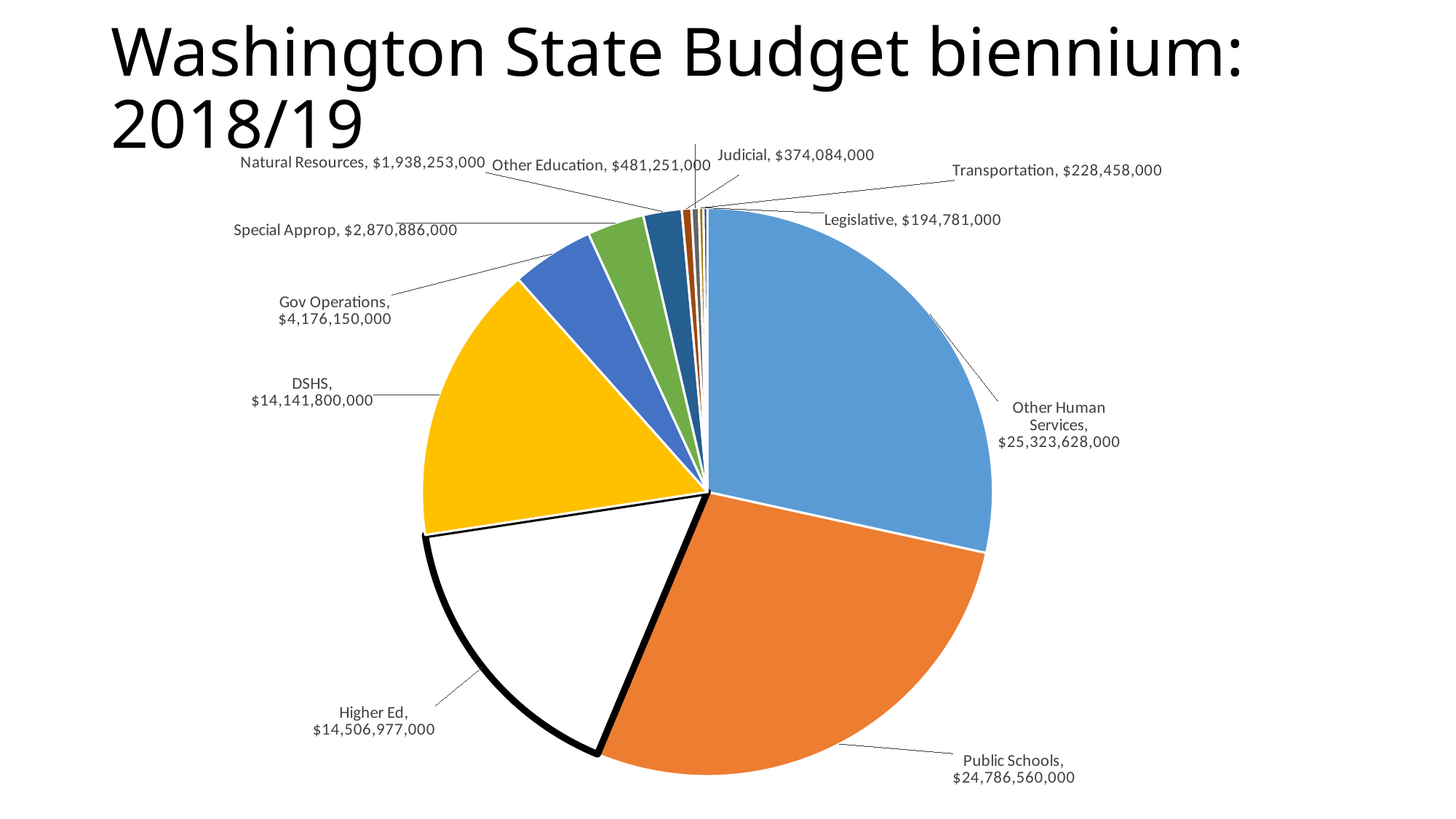
Which category has the largest value? Other Human Services Which is larger, Judicial or Transportation? Judicial What kind of chart is shown on the slide? Pie chart What is the difference between Higher Ed and DSHS? $365,177,000 What is the value for DSHS? $14,141,800,000 What is the title of the slide? Washington State Budget biennium: 2018/19 What is the difference between Other Human Services and Public Schools? $537,068,000 What is the value for Public Schools? $24,786,560,000 What is the value for Judicial? $374,084,000 What is the value for Gov Operations? $4,176,150,000 How many categories are shown in the pie chart? 11 Which category has the smallest value? Legislative